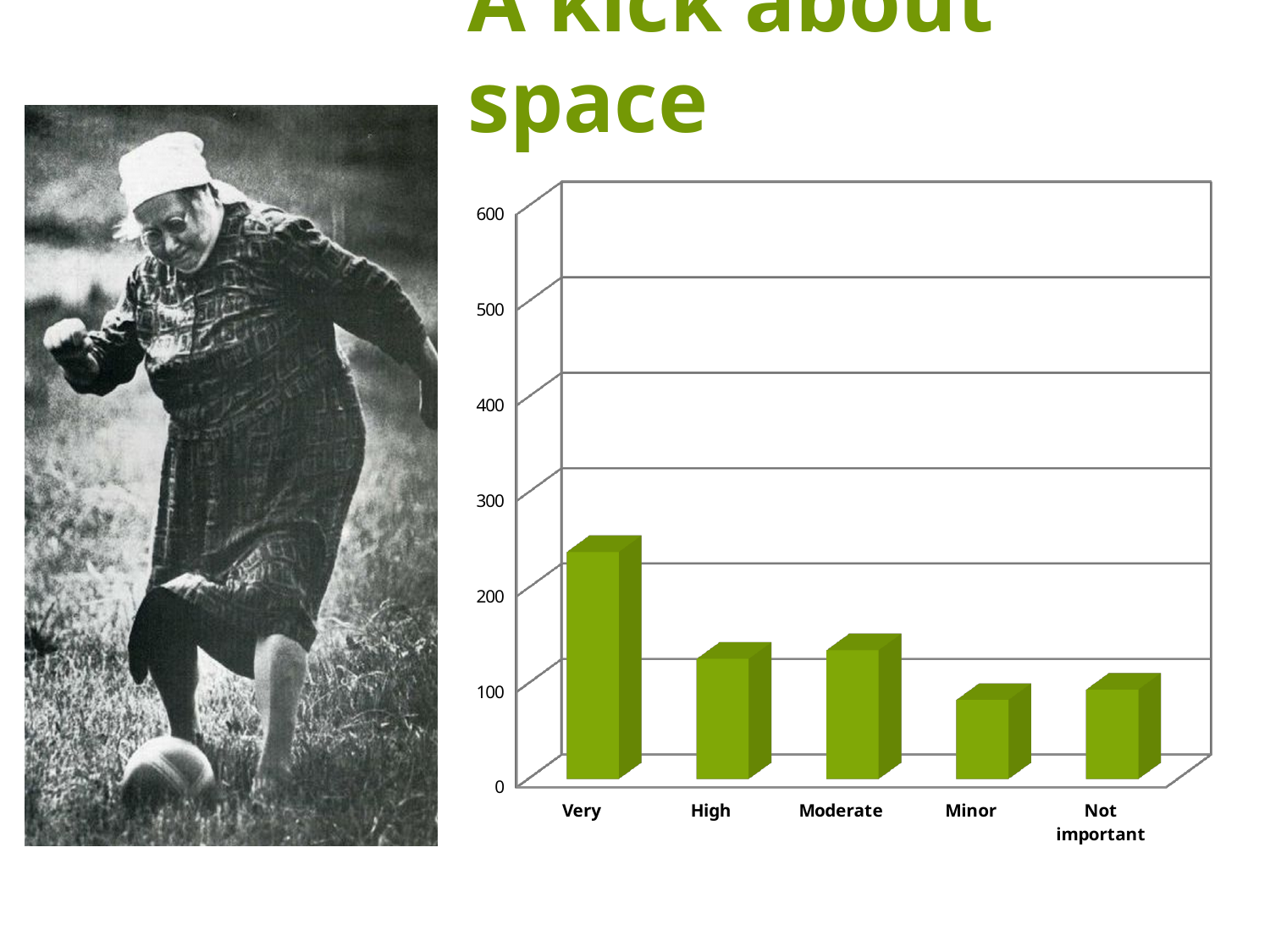
Which is larger, the value for Very or the value for High? Very Is the value for Moderate greater or less than 100? greater Which category has the highest bar in the chart? Very How many categories are shown on the x axis of the chart? 5 Which is larger, the value for Moderate or the value for Minor? Moderate Is the value for Very greater or less than 200? greater Is the value for High greater or less than 100? greater What is the label of the last category on the x axis? Not important What kind of chart is shown on the slide? bar chart